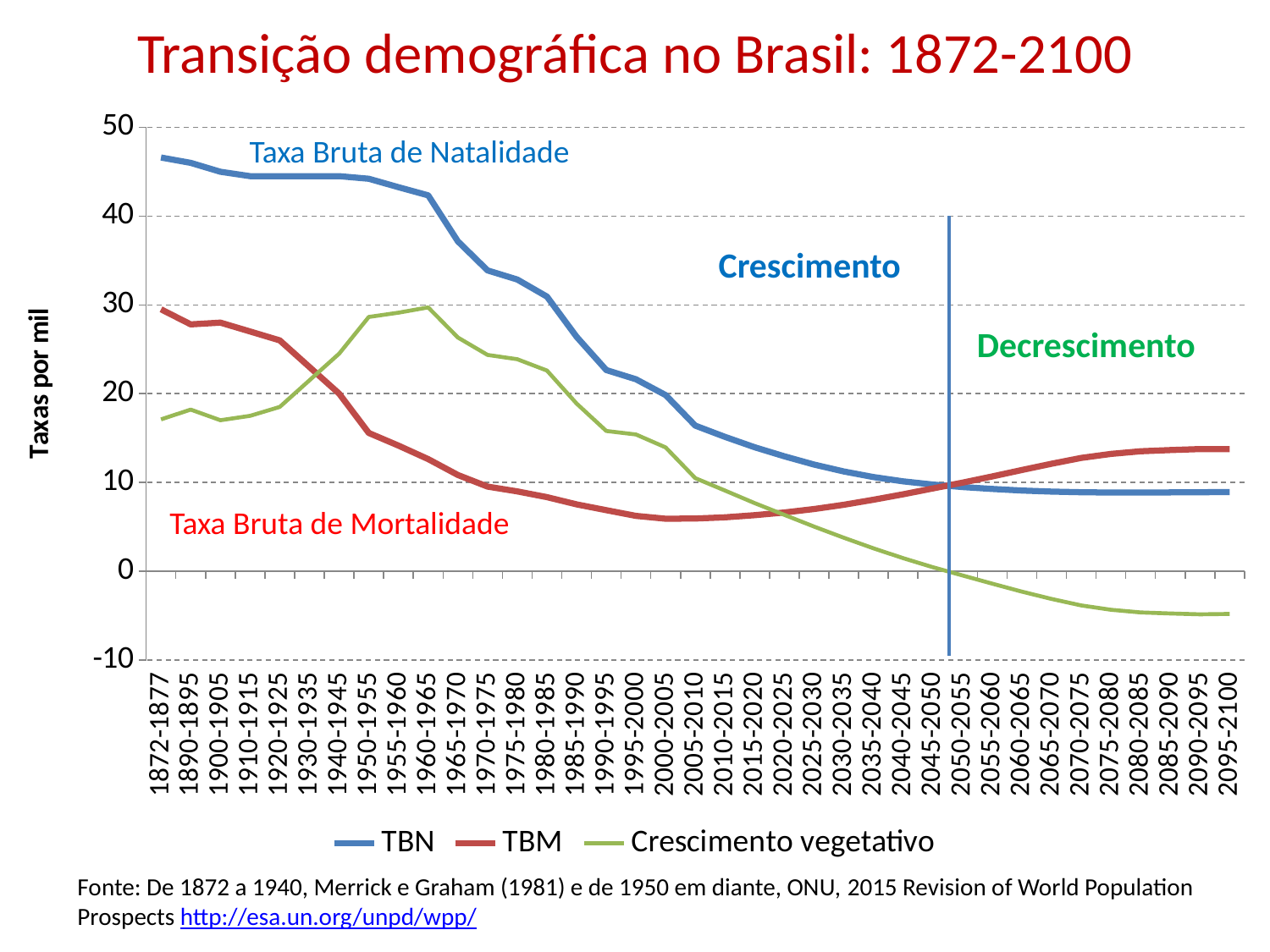
In 2095-2100, which is larger, TBN or TBM? TBM Is the TBN value for 1872-1877 greater or less than 40? greater What is the title of the chart? Transição demográfica no Brasil: 1872-2100 What kind of chart is shown on the slide? Line chart Does the TBN series rise or fall from 1872-1877 to 2095-2100? Fall Is the Crescimento vegetativo value for 1960-1965 greater or less than 20? greater Which series are listed in the legend? TBN, TBM, Crescimento vegetativo Is the Crescimento vegetativo value for 2095-2100 greater or less than 0? less How many periods are shown on the x axis? 37 In 1872-1877, which is larger, TBN or TBM? TBN How many series does the legend list? 3